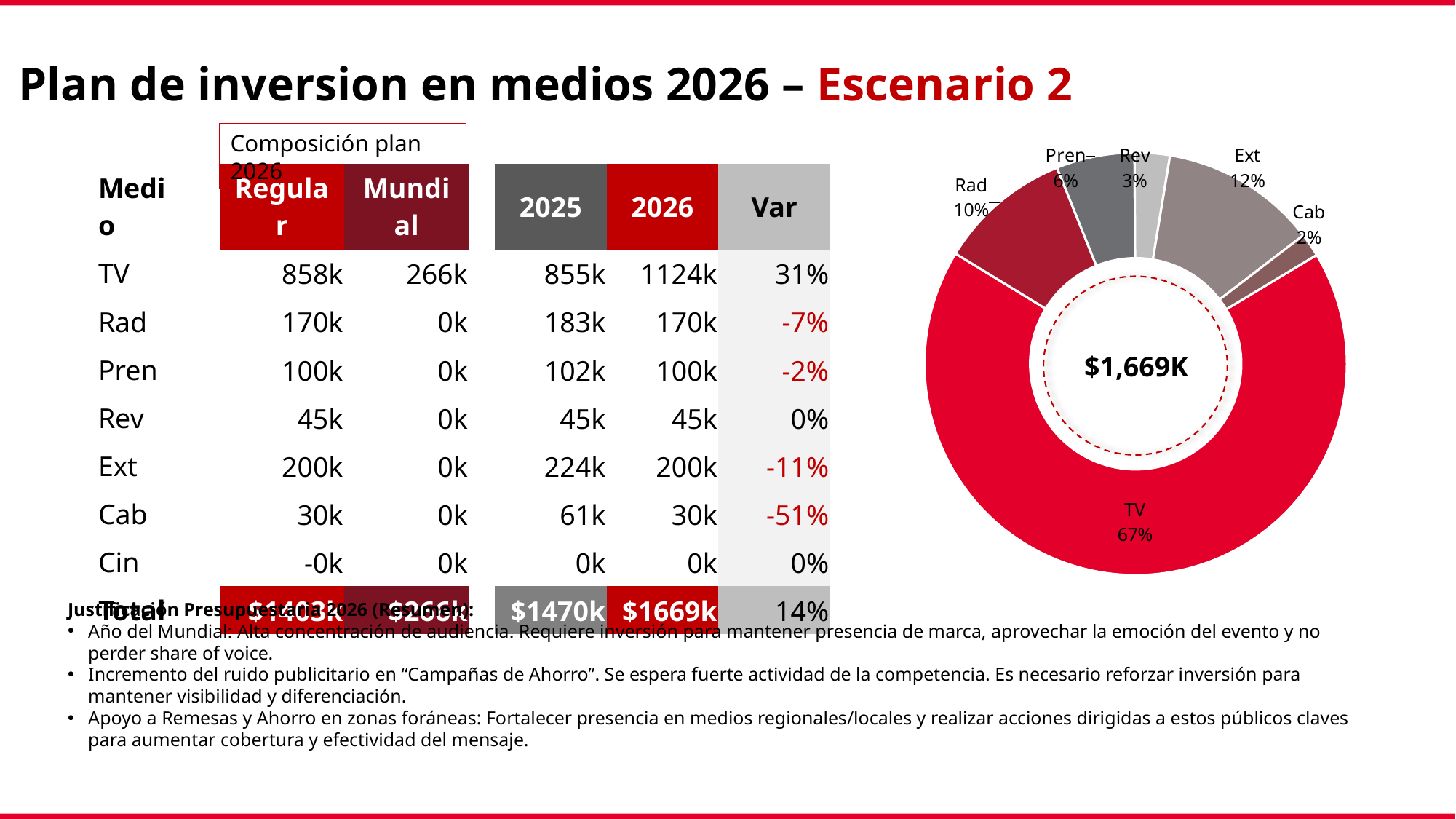
What is the combined share of the Rad and Pren slices in the donut chart? 16% Which labelled category has the smallest slice in the donut chart? Cab What share of the donut chart does Rad represent? 10% In the donut chart, which slice is larger, Pren or Rev? Pren What share of the donut chart does TV represent? 67% What is the difference in percentage points between the Ext and Rad slices in the donut chart? 2% How many labelled slices does the donut chart have? 6 What share of the donut chart does Cab represent? 2% What share of the donut chart does Ext represent? 12% What total value is printed in the centre of the donut chart? $1,669K What type of chart is shown on the right of the slide? Donut (pie) chart Which category has the largest slice in the donut chart? TV